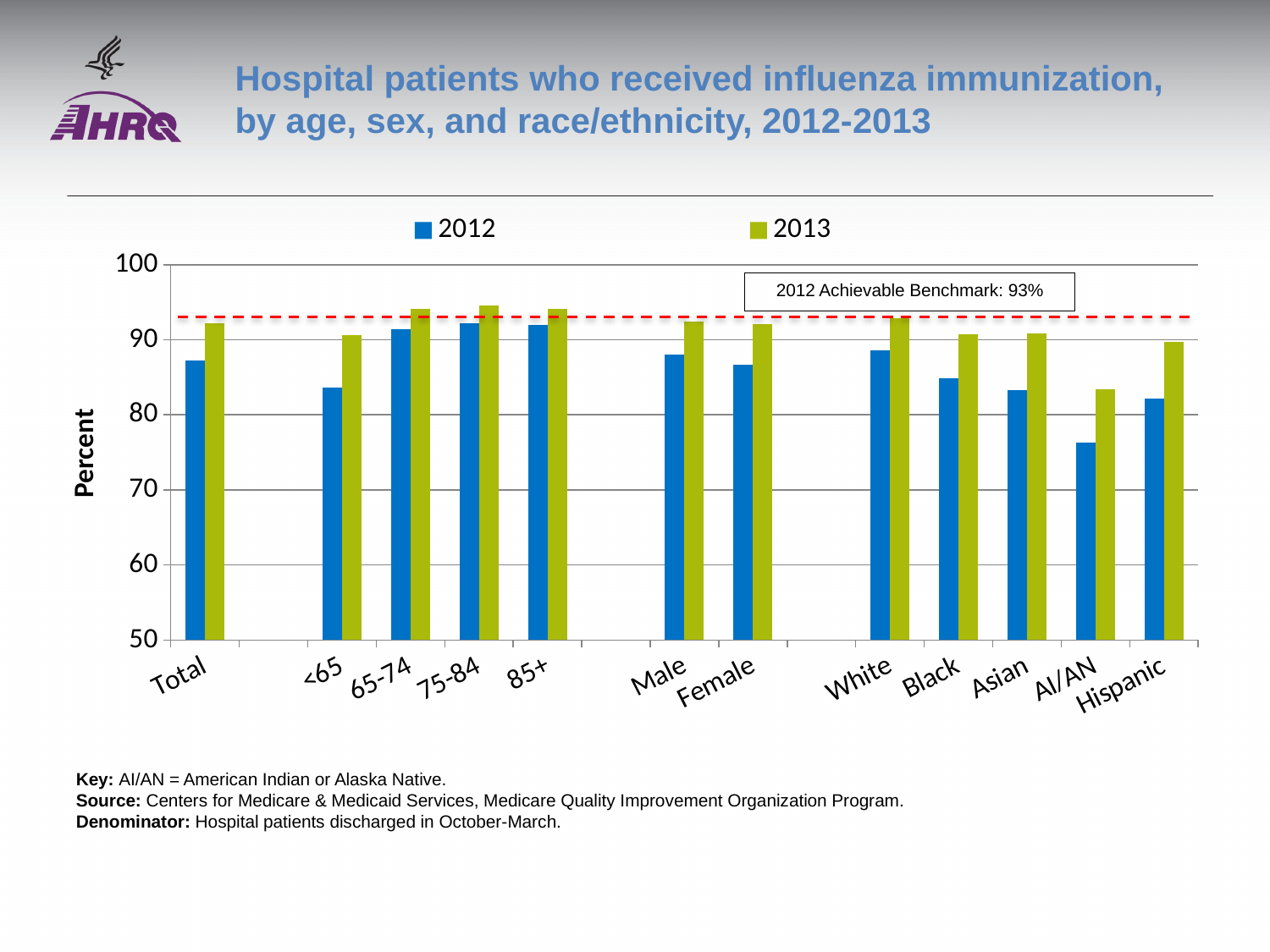
Is the 2012 value for Female greater or less than 90? less Which category has the lowest value for 2013? AI/AN How many categories are shown along the x axis? 12 For the Total category, which year has the larger value, 2012 or 2013? 2013 What is the 2012 Achievable Benchmark shown on the chart? 93% How many series does the legend list? 2 Is the 2012 value for AI/AN greater or less than 80? less Is the 2013 value for Total greater or less than 90? greater Which category has the lowest value for 2012? AI/AN What kind of chart is shown on the slide? Bar chart Which is larger, the 2012 value for White or the 2012 value for Black? White